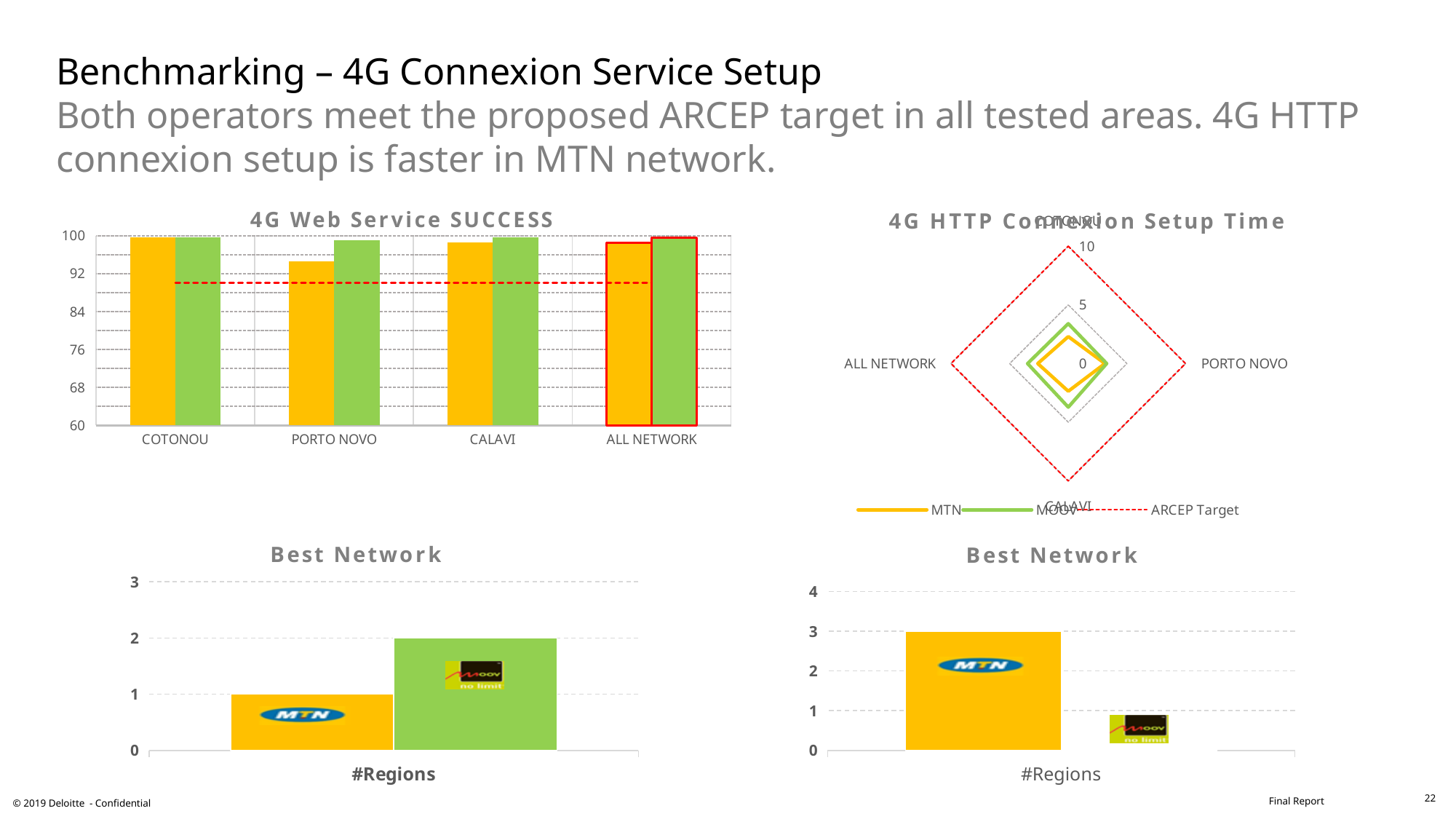
In the "4G Web Service SUCCESS" chart, which category has the lowest orange bar? PORTO NOVO In the bottom-left "Best Network" chart, what is the difference between the Moov and MTN values? 1 In the "4G HTTP Connexion Setup Time" chart, what value does the ARCEP Target line sit at on each axis? 10 In the bottom-right "Best Network" chart, which operator has the higher bar, MTN or Moov? MTN What kind of chart is the "4G Web Service SUCCESS" chart? Bar chart In the bottom-left "Best Network" chart, what is the value for Moov? 2 In the bottom-right "Best Network" chart, what is the value for MTN? 3 What kind of chart is the "4G HTTP Connexion Setup Time" chart? Radar chart How many series does the legend of the "4G HTTP Connexion Setup Time" chart list? 3 In the bottom-left "Best Network" chart, what is the value for MTN? 1 How many categories are shown on the x axis of the "4G Web Service SUCCESS" chart? 4 In the "4G Web Service SUCCESS" chart, is the orange bar for PORTO NOVO greater or less than 92? greater